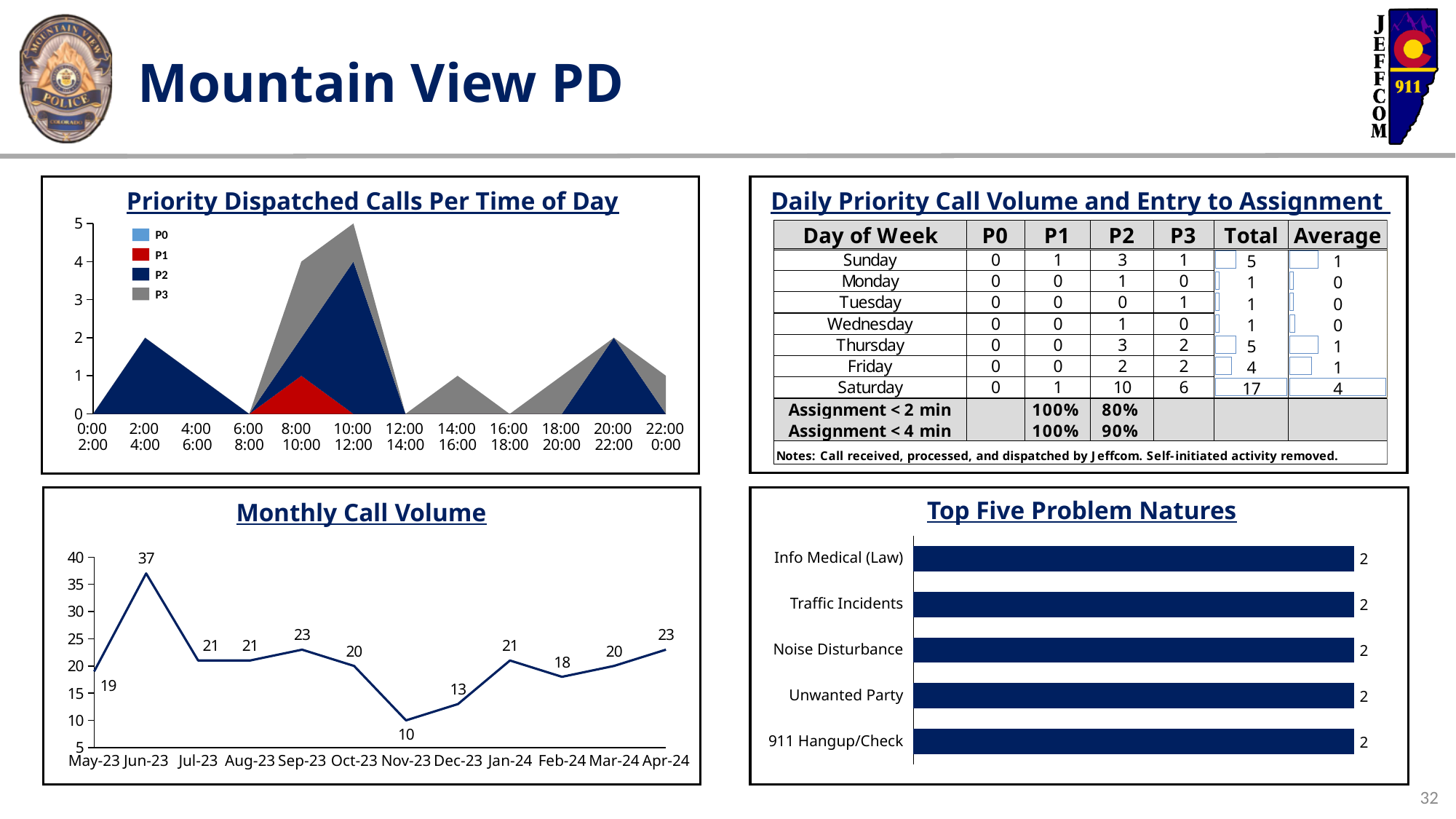
On the Monthly Call Volume chart, what is the value for Jun-23? 37 On the Monthly Call Volume chart, do the values rise or fall from Nov-23 to Jan-24? rise On the Monthly Call Volume chart, which month has the highest call volume? Jun-23 On the Priority Dispatched Calls Per Time of Day chart, is the stacked total for the 10:00-12:00 period greater or less than 3? greater On the Monthly Call Volume chart, which is larger, the value for Dec-23 or the value for Feb-24? Feb-24 On the Monthly Call Volume chart, what is the value for Nov-23? 10 How many months are plotted on the Monthly Call Volume chart? 12 On the Monthly Call Volume chart, what is the difference between the values for Jun-23 and Nov-23? 27 On the Top Five Problem Natures chart, what is the value for Noise Disturbance? 2 How many series does the legend of the Priority Dispatched Calls Per Time of Day chart list? 4 On the Monthly Call Volume chart, which month has the lowest call volume? Nov-23 What kind of chart is the Top Five Problem Natures chart? bar chart